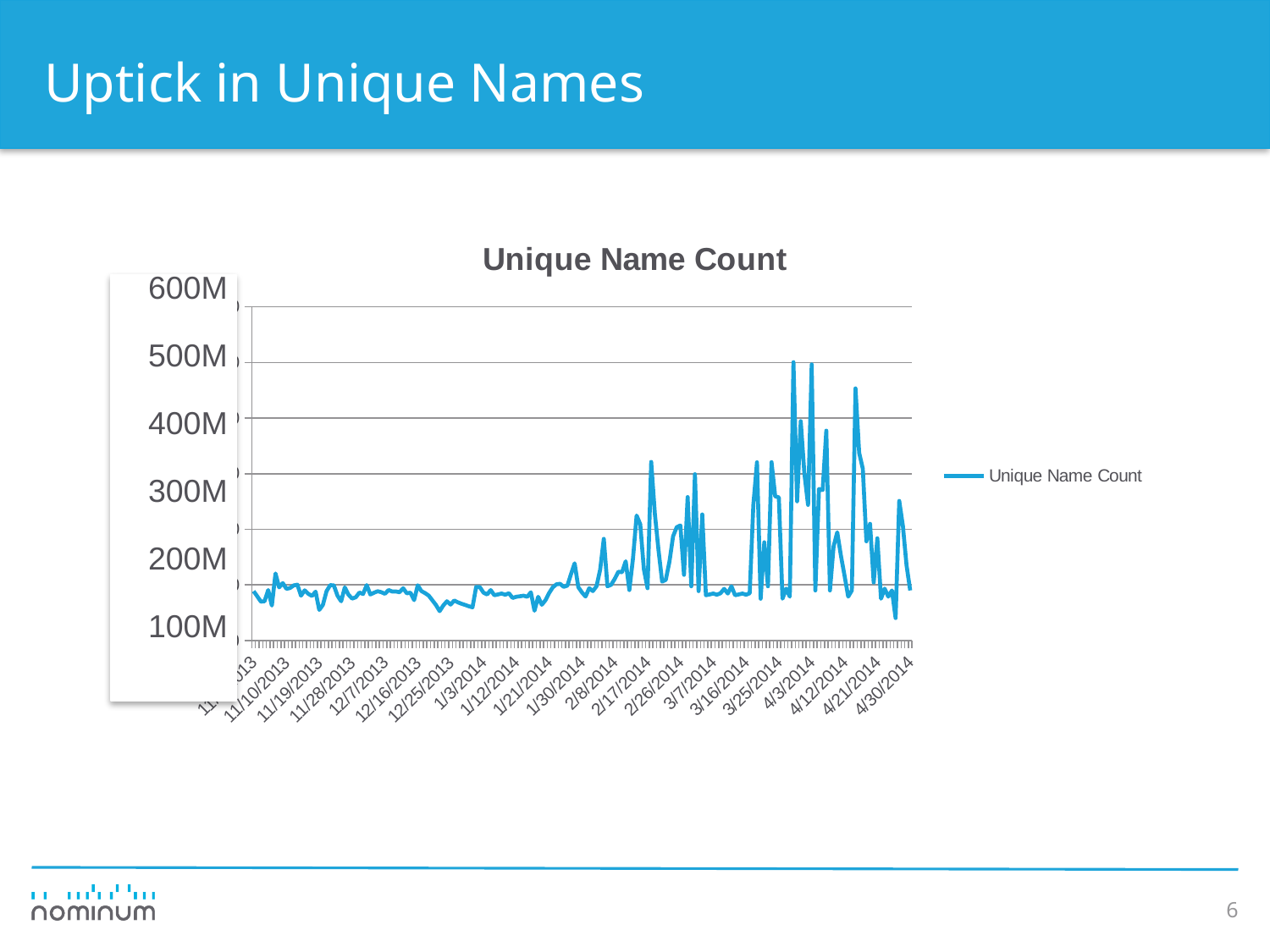
What is the highest value label shown on the vertical axis of the chart? 600M Is the Unique Name Count value around 11/19/2013 greater or less than 300M? less Are the Unique Name Count values in late March and early April 2014 generally higher or lower than the values in November 2013? higher What kind of chart is shown on the slide? line chart Is the Unique Name Count value around 12/25/2013 greater or less than 200M? less How many series does the legend of the chart list? 1 Is the peak Unique Name Count value around 4/3/2014 greater or less than 400M? greater What is the title of the chart? Unique Name Count Overall, do the Unique Name Count values rise or fall from the start of the x axis (November 2013) to the end (April 2014)? rise